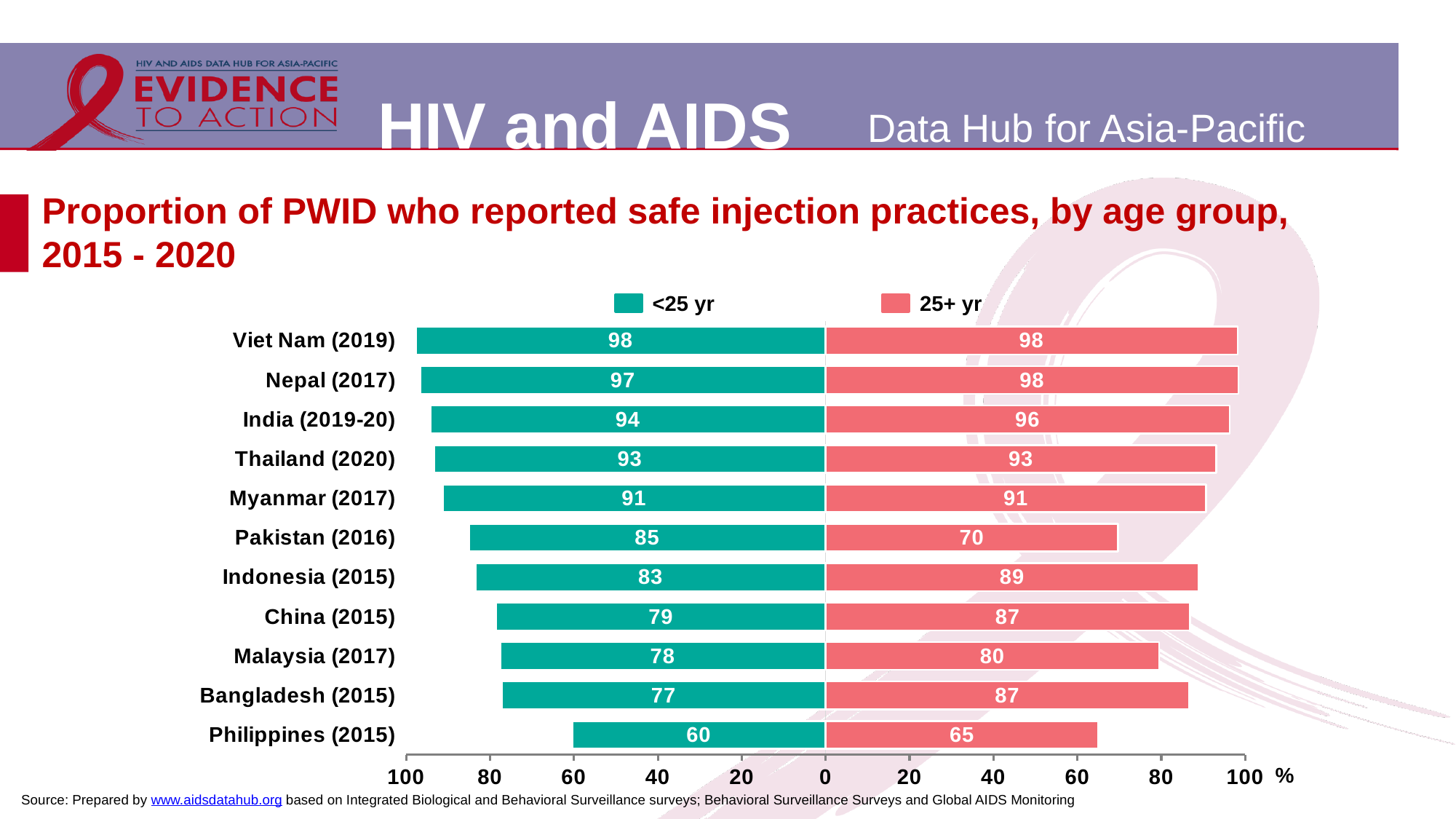
What is the value for Philippines (2015) in the <25 yr series? 60 What is the difference between the 25+ yr and <25 yr values for Bangladesh (2015)? 10 For China (2015), which age group has the larger value, <25 yr or 25+ yr? 25+ yr Which country has the highest value in the <25 yr series? Viet Nam (2019) What is the value for Pakistan (2016) in the <25 yr series? 85 How many countries are shown in the chart? 11 For Pakistan (2016), which age group has the larger value, <25 yr or 25+ yr? <25 yr What kind of chart is shown on the slide? Bar chart What is the difference between the 25+ yr and <25 yr values for Pakistan (2016)? 15 Which country has the lowest value in the 25+ yr series? Philippines (2015) What is the value for Bangladesh (2015) in the 25+ yr series? 87 How many series does the legend list? 2